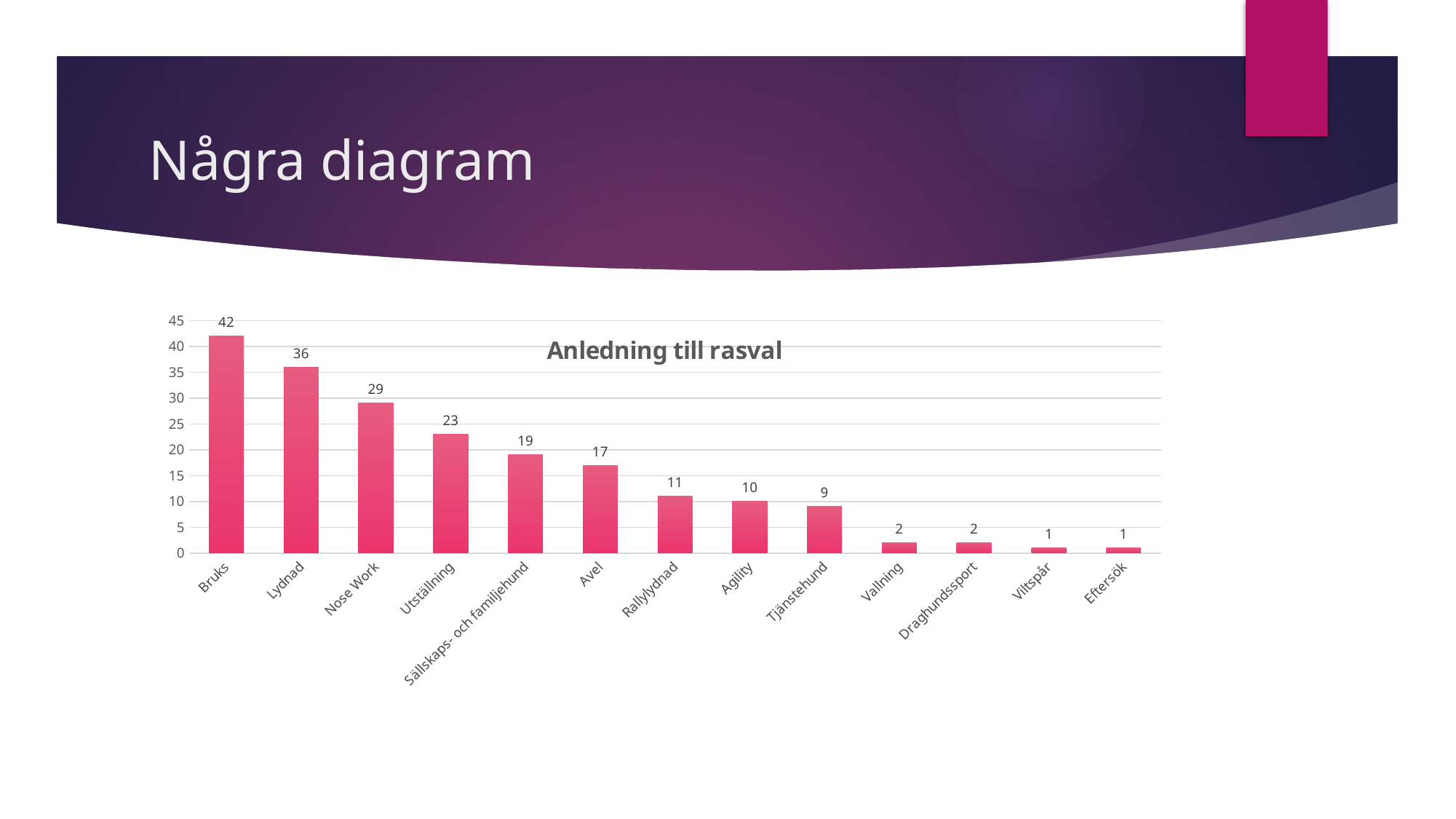
What kind of chart is shown on the slide? bar chart Do the values rise or fall from left to right along the x axis? fall What is the value for Bruks? 42 What is the value for Sällskaps- och familjehund? 19 What is the value for Tjänstehund? 9 Which category has the highest value? Bruks What is the title of the chart? Anledning till rasval What is the difference between the values for Lydnad and Utställning? 13 Which is larger, the value for Avel or the value for Rallylydnad? Avel Is the value for Agility greater or less than 15? less How many categories are shown on the x axis? 13 What is the value for Nose Work? 29